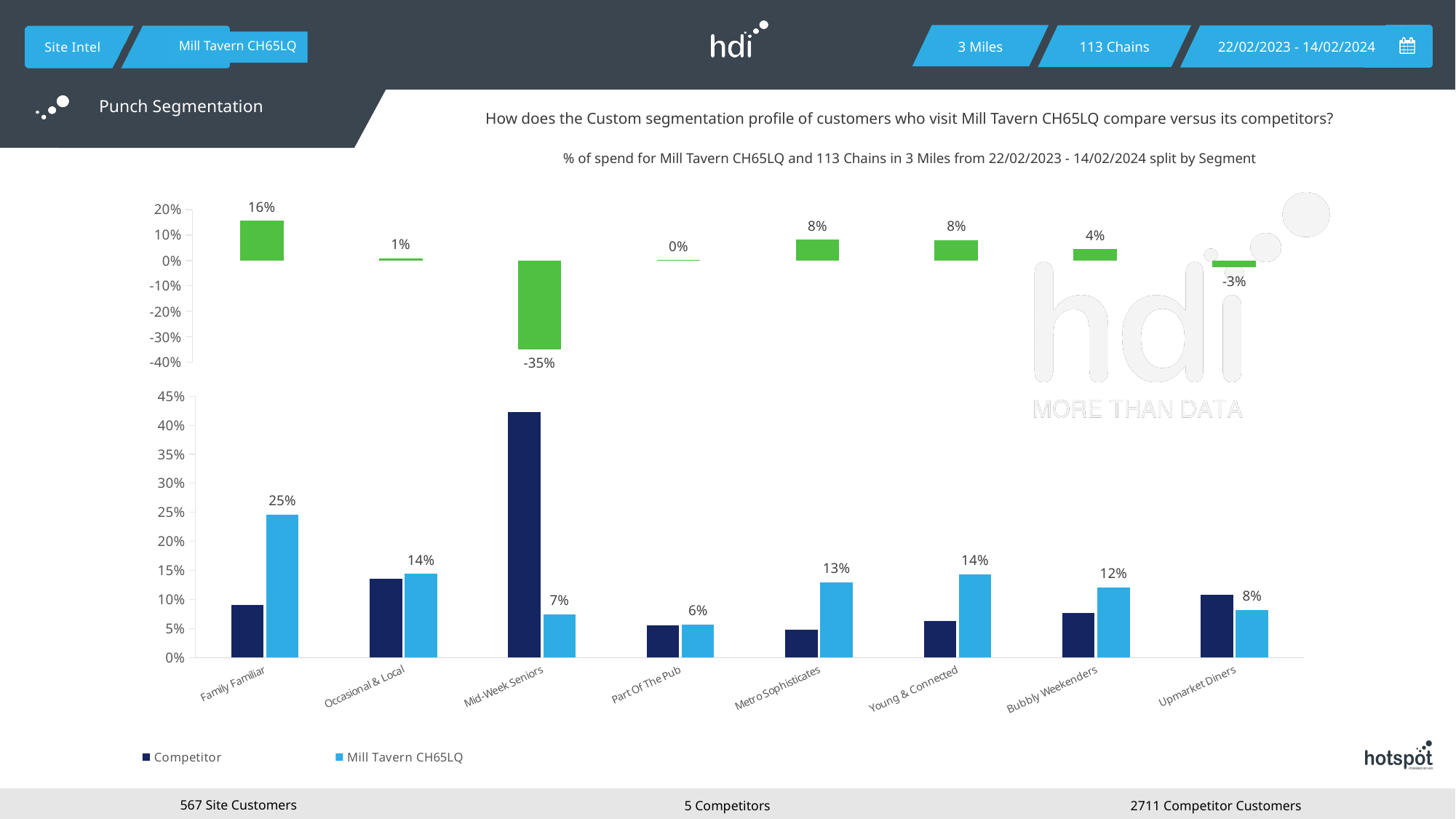
In the bottom chart, what is the difference between the Mill Tavern CH65LQ values for Family Familiar and Mid-Week Seniors? 18% In the bottom chart, which is larger for Mid-Week Seniors: the Competitor value or the Mill Tavern CH65LQ value? Competitor In the top chart, what is the value shown for Upmarket Diners? -3% In the bottom chart, what is the value for Mill Tavern CH65LQ in the Family Familiar segment? 25% In the bottom chart, which segment has the highest Mill Tavern CH65LQ value? Family Familiar How many segments are shown on the x axis of the bottom chart? 8 In the bottom chart, is the Competitor value for Mid-Week Seniors greater or less than 40%? greater In the bottom chart, what is the value for Mill Tavern CH65LQ in the Bubbly Weekenders segment? 12% How many series does the legend of the bottom chart list? 2 In the top chart, which segment has the lowest value? Mid-Week Seniors In the top chart, what is the value shown for Mid-Week Seniors? -35% In the top chart, which segment has the highest value? Family Familiar